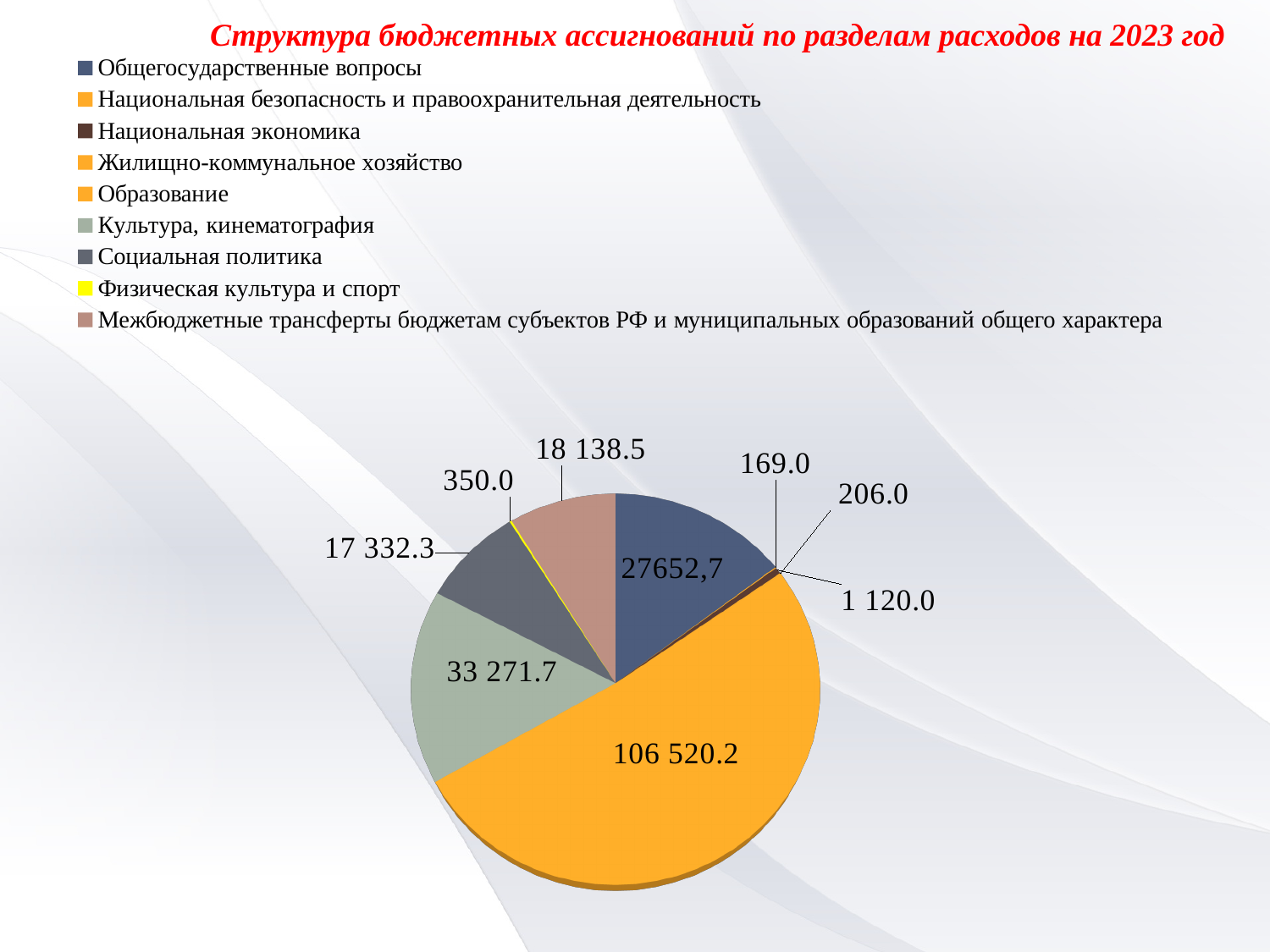
What is the title of the chart? Структура бюджетных ассигнований по разделам расходов на 2023 год What is the value shown for Социальная политика? 17 332.3 What is the value shown for Межбюджетные трансферты бюджетам субъектов РФ и муниципальных образований общего характера? 18 138.5 What is the value shown for Образование? 106 520.2 What is the value shown for Физическая культура и спорт? 350.0 What is the difference between the values for Межбюджетные трансферты (18 138.5) and Социальная политика (17 332.3)? 806.2 Which category has the largest slice of the pie? Образование How many categories does the legend of the pie chart list? 9 Which is larger: Межбюджетные трансферты or Социальная политика? Межбюджетные трансферты What is the value shown for Культура, кинематография? 33 271.7 What is the value shown for Общегосударственные вопросы? 27652,7 What kind of chart is shown on the slide? pie chart